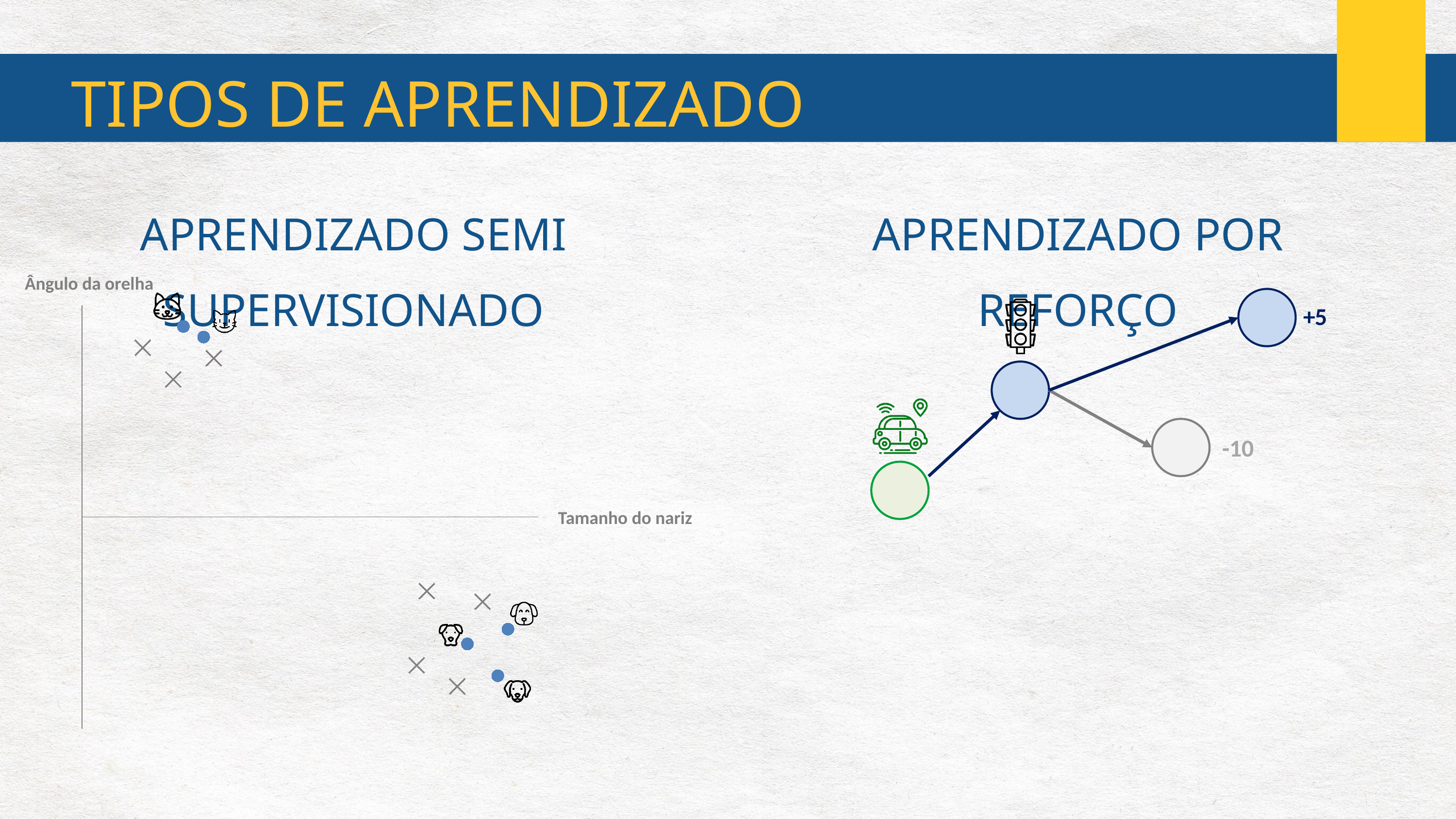
In the scatter chart on the left, which cluster has the higher 'Ângulo da orelha' values, the cat cluster or the dog cluster? the cat cluster In the scatter chart on the left, how many points are in the cat cluster near the top left? 5 In the scatter chart on the left, how many filled blue dots are plotted in total? 5 In the scatter chart on the left, what is the label of the vertical axis? Ângulo da orelha In the scatter chart on the left, what is the label of the horizontal axis? Tamanho do nariz In the scatter chart on the left, how many X marks are plotted in total? 7 What kind of chart is shown under the heading 'Aprendizado semi supervisionado'? scatter chart In the scatter chart on the left, which cluster has the larger 'Tamanho do nariz' values, the cat cluster or the dog cluster? the dog cluster